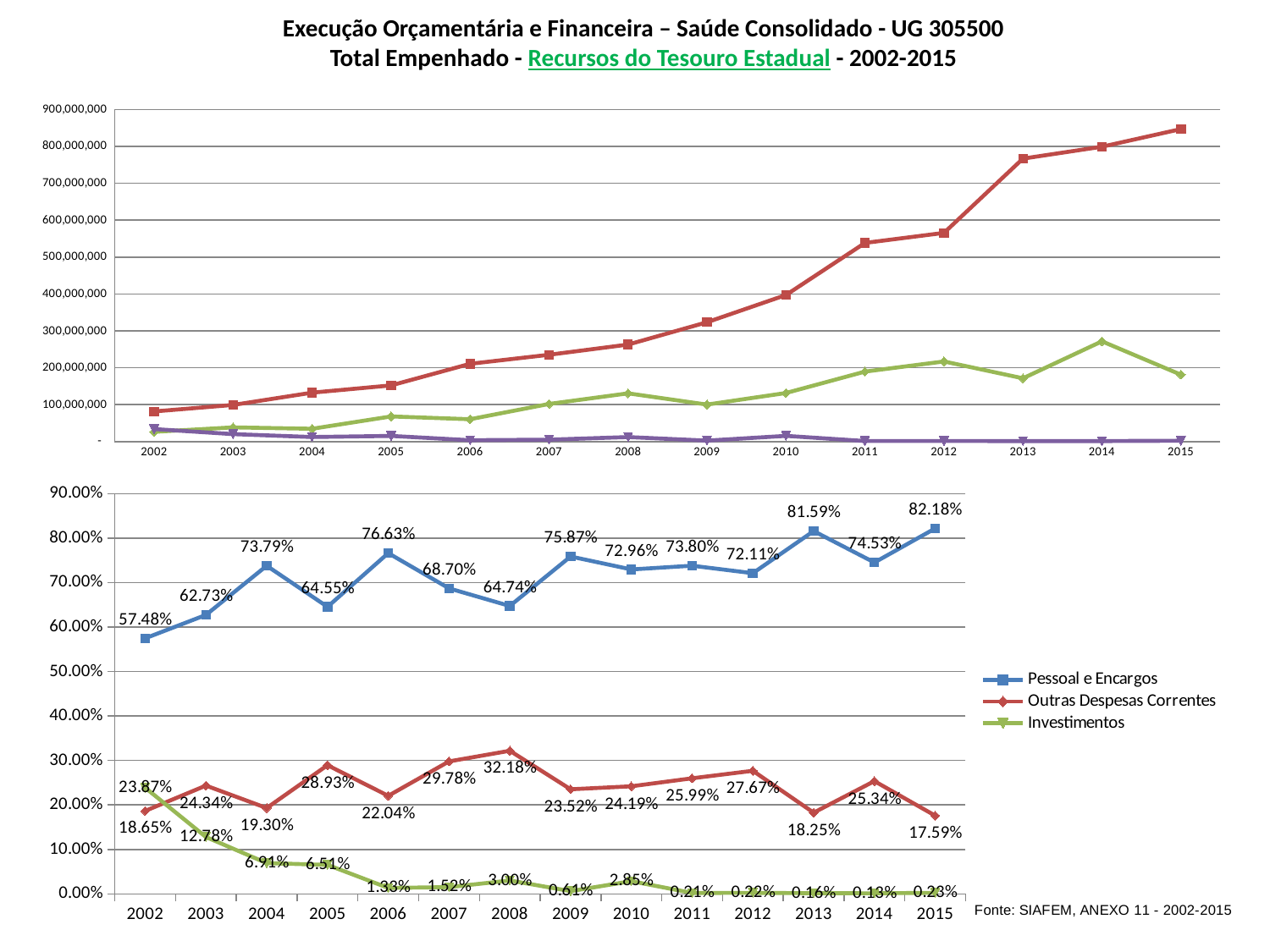
In the bottom chart, in which year is Pessoal e Encargos highest? 2015 In the bottom chart, does the Investimentos series generally rise or fall from 2002 to 2015? fall What kind of chart is the bottom chart? line chart In the bottom chart, which is larger in 2002: Outras Despesas Correntes or Investimentos? Investimentos How many years are plotted on the x axis of the bottom chart? 14 In the bottom chart, what is the difference between Pessoal e Encargos in 2015 and in 2002? 24.70% In the bottom chart, what is the value for Outras Despesas Correntes in 2008? 32.18% How many series does the legend list? 3 In the bottom chart, what is the value for Pessoal e Encargos in 2002? 57.48% In the bottom chart, what is the value for Investimentos in 2005? 6.51% In the top chart, is the value of the red line in 2015 greater or less than 800,000,000? greater In the bottom chart, in which year is Investimentos lowest? 2014